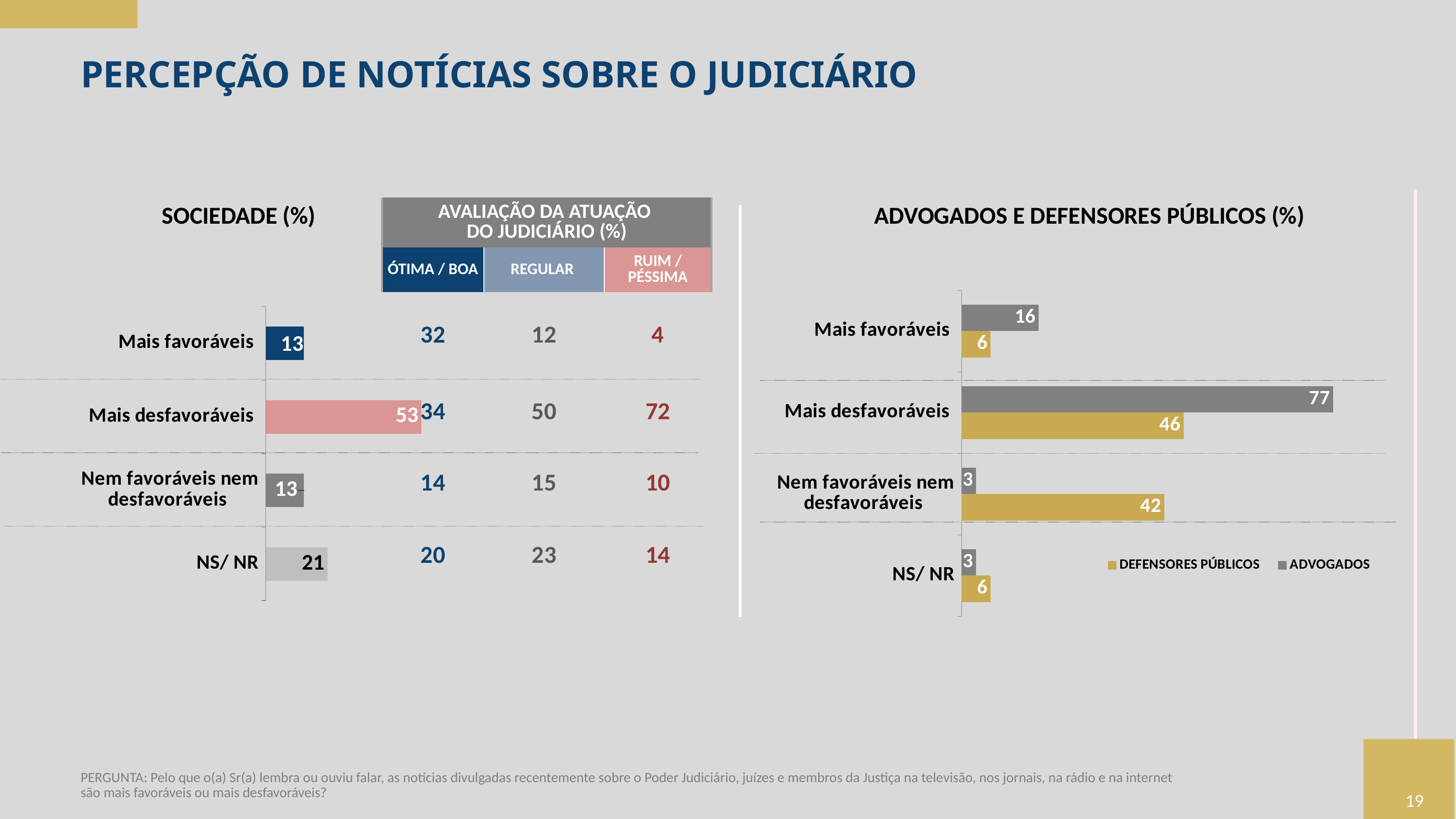
In the SOCIEDADE (%) chart, what is the difference between Mais desfavoráveis and NS/ NR? 32 In the SOCIEDADE (%) chart, which category has the highest value? Mais desfavoráveis What kind of chart is the SOCIEDADE (%) chart? Bar chart In the SOCIEDADE (%) chart, how many categories are shown? 4 How many series does the legend of the ADVOGADOS E DEFENSORES PÚBLICOS (%) chart list? 2 In the ADVOGADOS E DEFENSORES PÚBLICOS (%) chart, what is the value for ADVOGADOS in Mais desfavoráveis? 77 In the ADVOGADOS E DEFENSORES PÚBLICOS (%) chart, which category has the lowest value for DEFENSORES PÚBLICOS? Mais favoráveis and NS/ NR (both 6) In the ADVOGADOS E DEFENSORES PÚBLICOS (%) chart, what is the difference between ADVOGADOS and DEFENSORES PÚBLICOS for Mais desfavoráveis? 31 In the ADVOGADOS E DEFENSORES PÚBLICOS (%) chart, which is larger for Mais favoráveis: ADVOGADOS or DEFENSORES PÚBLICOS? ADVOGADOS In the SOCIEDADE (%) chart, what is the value for Mais desfavoráveis? 53 In the ADVOGADOS E DEFENSORES PÚBLICOS (%) chart, what is the value for DEFENSORES PÚBLICOS in Nem favoráveis nem desfavoráveis? 42 In the SOCIEDADE (%) chart, what is the value for NS/ NR? 21